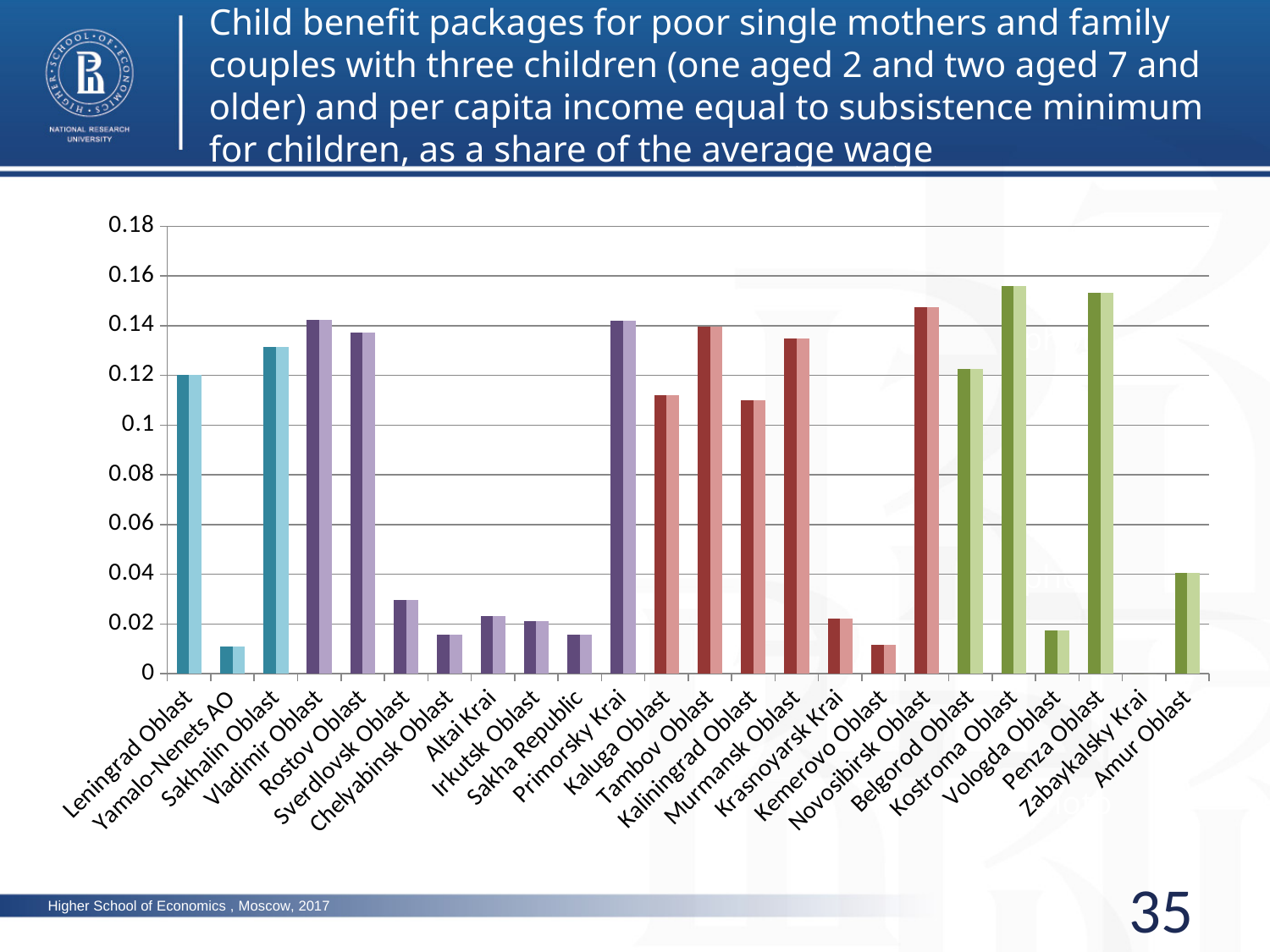
Is the value for Kaluga Oblast greater or less than 0.1? greater Is the value for Kemerovo Oblast greater or less than 0.02? less What kind of chart is shown on the slide? Bar chart Which has the larger value, Sakhalin Oblast or Leningrad Oblast? Sakhalin Oblast What is the highest value shown on the vertical axis of the chart? 0.18 Is the value for Sakhalin Oblast greater or less than 0.12? greater Which has the larger value, Tambov Oblast or Kaliningrad Oblast? Tambov Oblast How many regions are listed along the x axis of the chart? 24 Which region has the lowest value in the chart? Zabaykalsky Krai Which has the larger value, Kostroma Oblast or Vologda Oblast? Kostroma Oblast